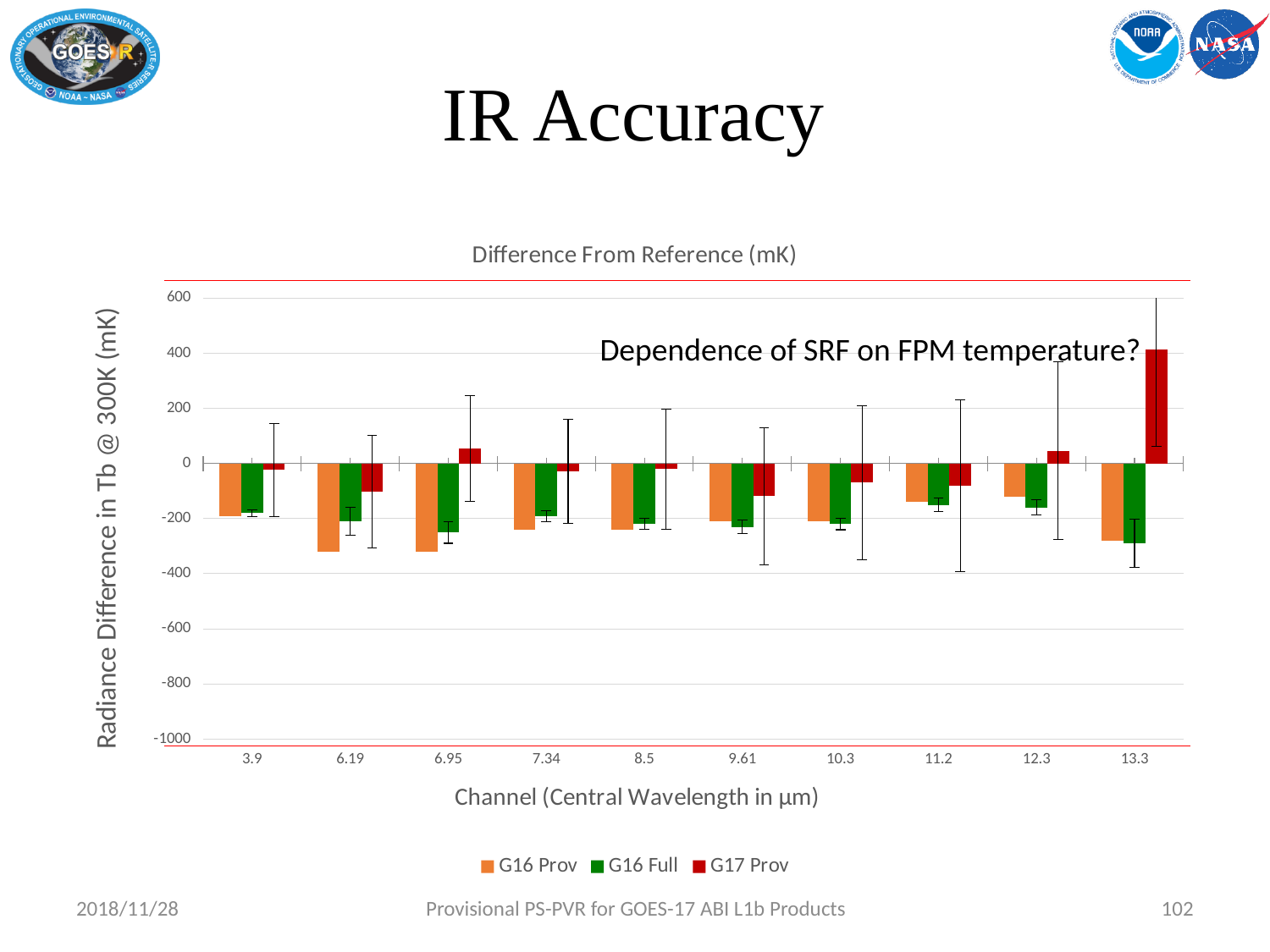
What kind of chart is shown on the slide? bar chart How many channel categories are shown on the x axis? 10 Is the G16 Prov value for channel 6.19 greater or less than -200? less Is the G16 Prov value for channel 3.9 greater or less than 0? less How many series does the legend list? 3 Is the G17 Prov value for channel 13.3 greater or less than 200? greater Which series is shown in dark red in the legend? G17 Prov For the G17 Prov series, which is larger: the value for channel 12.3 or the value for channel 13.3? 13.3 For the G16 Prov series, which is larger: the value for channel 3.9 or the value for channel 6.19? 3.9 What is the title of the chart? Difference From Reference (mK) For the G17 Prov series, which channel has the highest value? 13.3